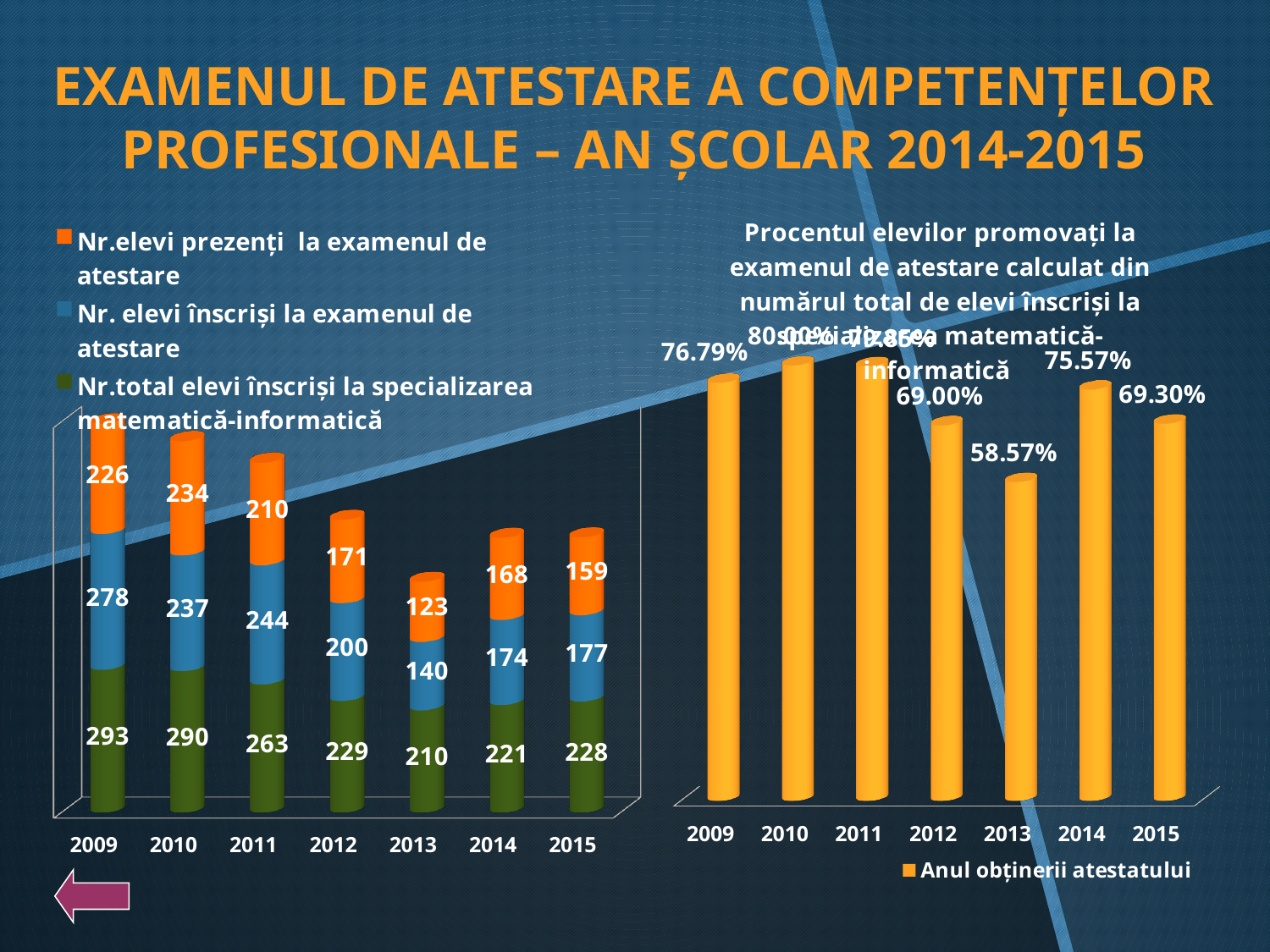
In the left stacked bar chart, what is the total of the stacked bar for 2013? 473 In the left stacked bar chart, what is the value of 'Nr.total elevi înscriși la specializarea matematică-informatică' for 2009? 293 In the left stacked bar chart, which year has the lowest value for 'Nr.elevi prezenți la examenul de atestare'? 2013 In the left stacked bar chart, what is the value of 'Nr. elevi înscriși la examenul de atestare' for 2015? 177 In the left stacked bar chart, which year has the highest value for 'Nr.total elevi înscriși la specializarea matematică-informatică'? 2009 In the chart 'Procentul elevilor promovați la examenul de atestare', which year has the lowest value? 2013 How many years are shown on the x axis of the left stacked bar chart? 7 In the left stacked bar chart, what is the value of 'Nr.elevi prezenți la examenul de atestare' for 2013? 123 How many series does the legend of the left stacked bar chart list? 3 In the left stacked bar chart, what is the difference between the 'Nr.total elevi înscriși la specializarea matematică-informatică' values for 2009 and 2015? 65 In the chart 'Procentul elevilor promovați la examenul de atestare', is the value for 2014 larger or smaller than the value for 2015? larger In the chart 'Procentul elevilor promovați la examenul de atestare', what is the value for 2013? 58.57%